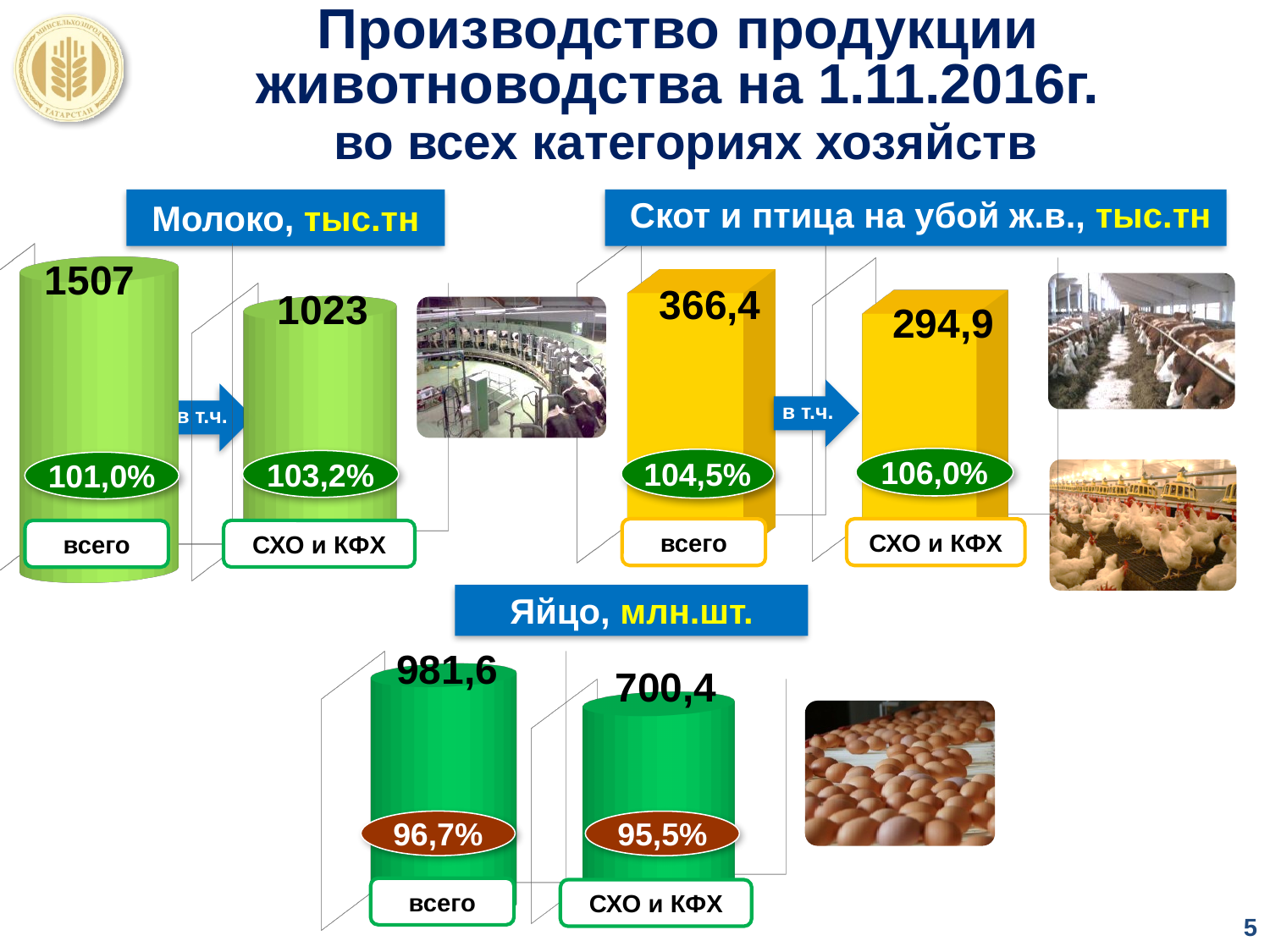
In the "Скот и птица на убой ж.в., тыс.тн" chart, what is the value for "СХО и КФХ"? 294,9 In the "Молоко, тыс.тн" chart, what is the value for "СХО и КФХ"? 1023 In the "Яйцо, млн.шт." chart, which category has the higher value, "всего" or "СХО и КФХ"? всего In the "Скот и птица на убой ж.в., тыс.тн" chart, what is the value for "всего"? 366,4 In the "Молоко, тыс.тн" chart, what is the value for "всего"? 1507 In the "Молоко, тыс.тн" chart, what is the difference between the "всего" and "СХО и КФХ" values? 484 In the "Яйцо, млн.шт." chart, what is the value for "всего"? 981,6 In the "Молоко, тыс.тн" chart, what percentage is shown on the "СХО и КФХ" bar? 103,2% How many bars does the "Скот и птица на убой ж.в., тыс.тн" chart have? 2 What kind of chart is the "Яйцо, млн.шт." chart? bar chart In the "Скот и птица на убой ж.в., тыс.тн" chart, what percentage is shown on the "всего" bar? 104,5% In the "Яйцо, млн.шт." chart, what percentage is shown on the "СХО и КФХ" bar? 95,5%